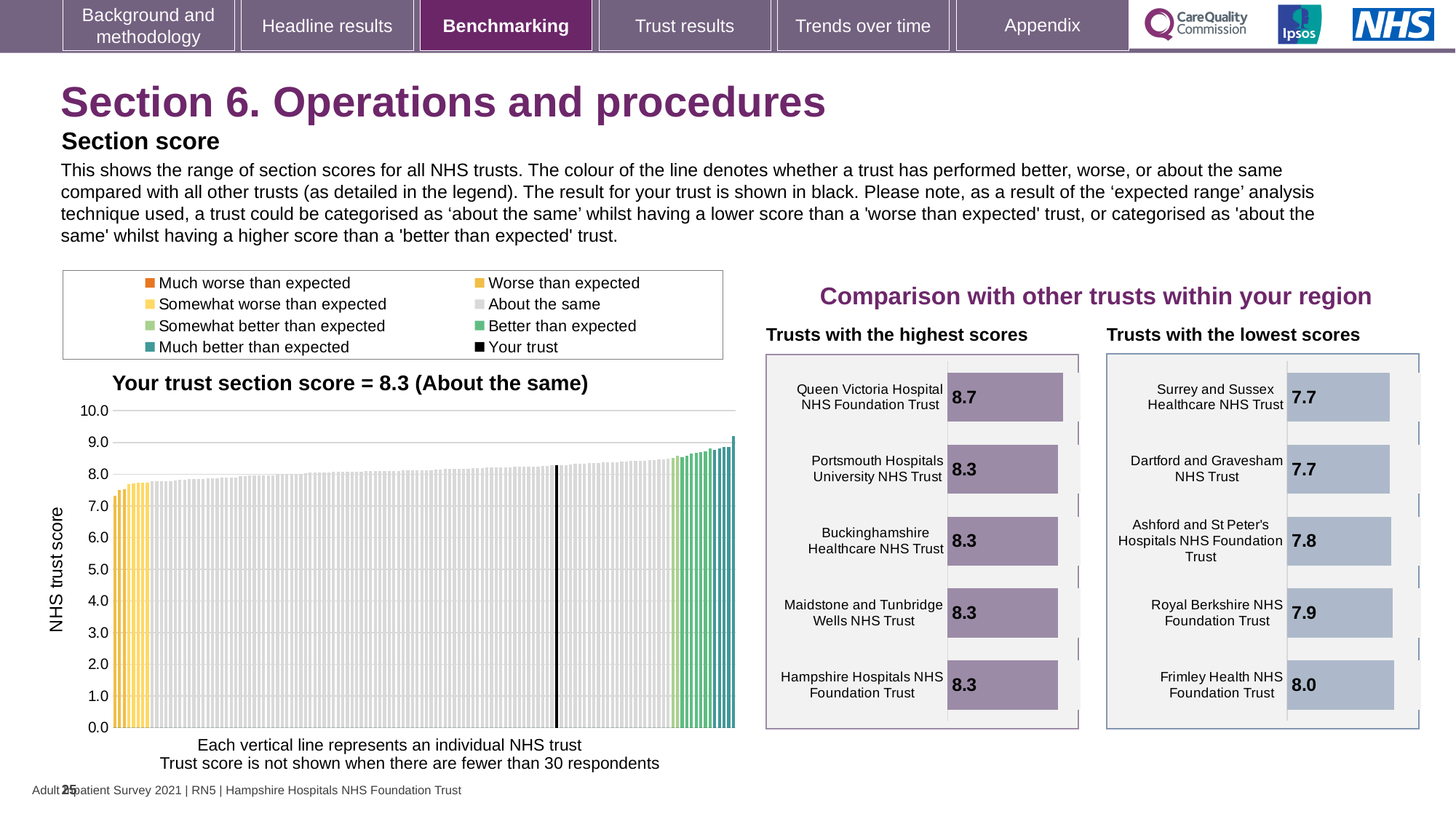
In the chart titled 'Your trust section score = 8.3 (About the same)', how many entries does the legend list? 8 In the chart titled 'Your trust section score = 8.3 (About the same)', what kind of chart is shown? Bar chart In the 'Trusts with the highest scores' chart, what is the difference between the scores of Queen Victoria Hospital NHS Foundation Trust and Portsmouth Hospitals University NHS Trust? 0.4 In the chart titled 'Your trust section score = 8.3 (About the same)', what is the label on the vertical axis? NHS trust score In the chart titled 'Your trust section score = 8.3 (About the same)', what is the section score for your trust? 8.3 In the 'Trusts with the highest scores' chart, what is the score for Queen Victoria Hospital NHS Foundation Trust? 8.7 In the 'Trusts with the highest scores' chart, how many trusts are shown? 5 In the 'Trusts with the lowest scores' chart, which trust has the highest score? Frimley Health NHS Foundation Trust In the chart titled 'Your trust section score = 8.3 (About the same)', is the lowest trust score greater or less than 7.0? greater In the 'Trusts with the lowest scores' chart, what is the score for Royal Berkshire NHS Foundation Trust? 7.9 In the 'Trusts with the highest scores' chart, which trust has the highest score? Queen Victoria Hospital NHS Foundation Trust In the chart titled 'Your trust section score = 8.3 (About the same)', do the trust scores rise or fall from left to right? Rise